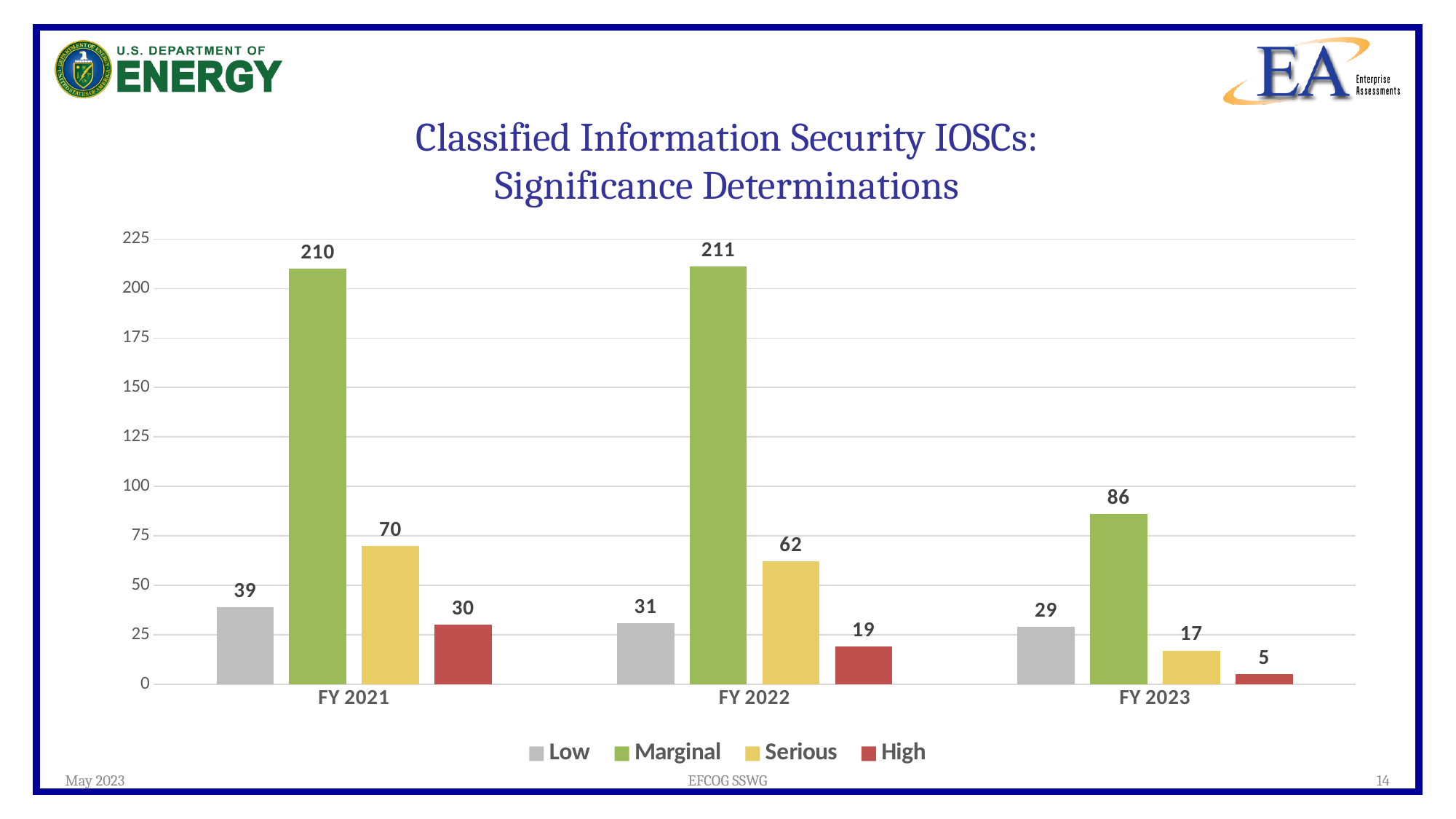
Which fiscal year has the lowest Low value? FY 2023 What is the Serious value for FY 2021? 70 Is the Marginal value for FY 2023 greater or less than 100? less Do the High values rise or fall from FY 2021 to FY 2023? fall What is the High value for FY 2023? 5 How many series does the legend list? 4 What is the difference between the Marginal values for FY 2022 and FY 2023? 125 What is the Marginal value for FY 2022? 211 What kind of chart is shown on the slide? bar chart Which fiscal year has the highest Marginal value? FY 2022 How many fiscal years are shown on the x axis? 3 Which is larger, the Serious value for FY 2021 or the Serious value for FY 2022? FY 2021